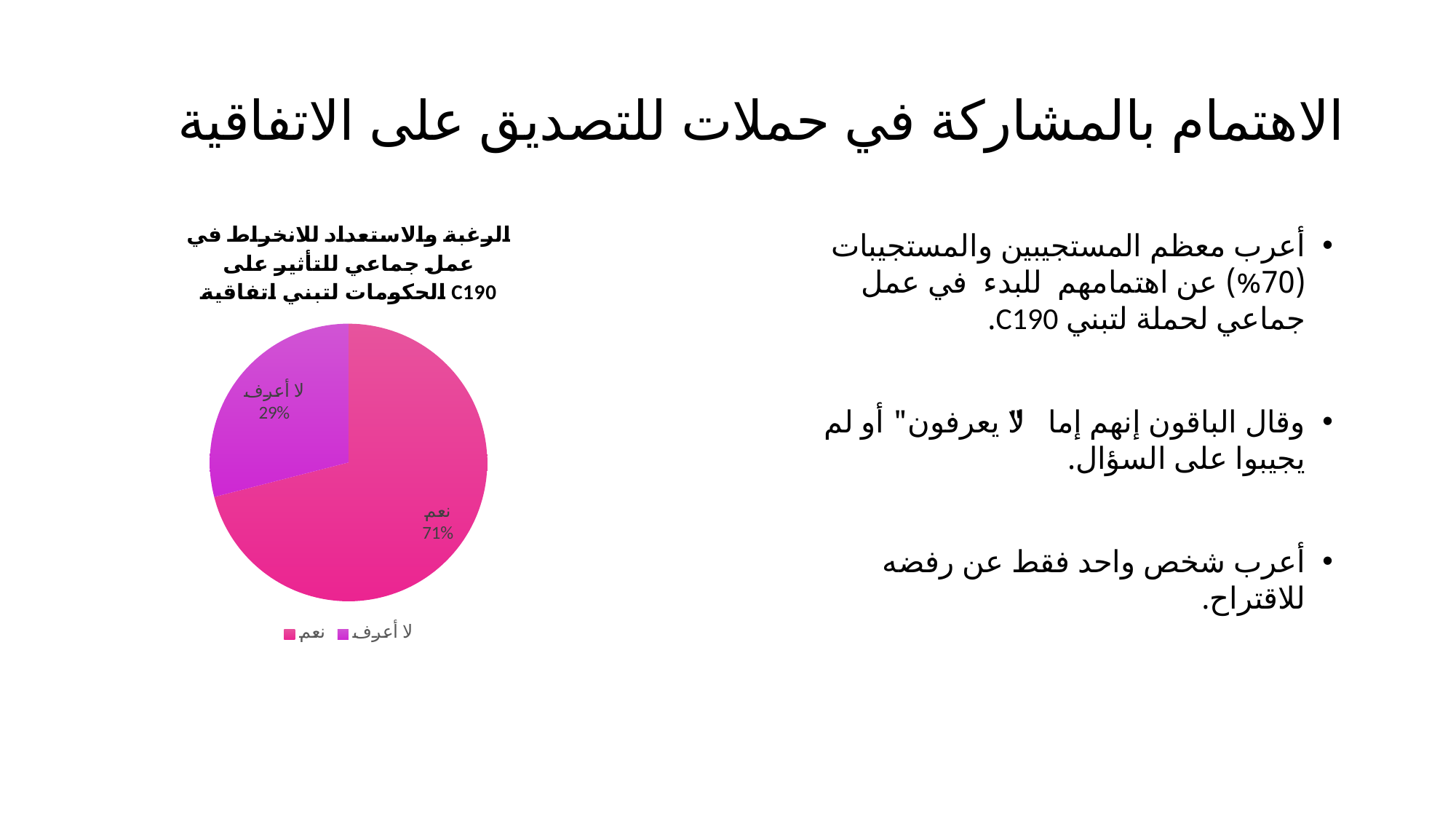
How many entries does the legend of the pie chart list? 2 What share of the pie does the "نعم" slice represent? 71% Which slice of the pie chart is the largest? نعم What percentage of the pie is labelled "لا أعرف"? 29% What colour is the "لا أعرف" slice in the pie chart? purple What is the difference in percentage points between the "نعم" slice and the "لا أعرف" slice? 42 What kind of chart is shown on the slide? pie chart How many slices does the pie chart have? 2 Which slice of the pie chart is the smallest? لا أعرف What colour is the "نعم" slice in the pie chart? pink Which is larger, the "نعم" slice or the "لا أعرف" slice? نعم What percentage of the pie is labelled "نعم"? 71%